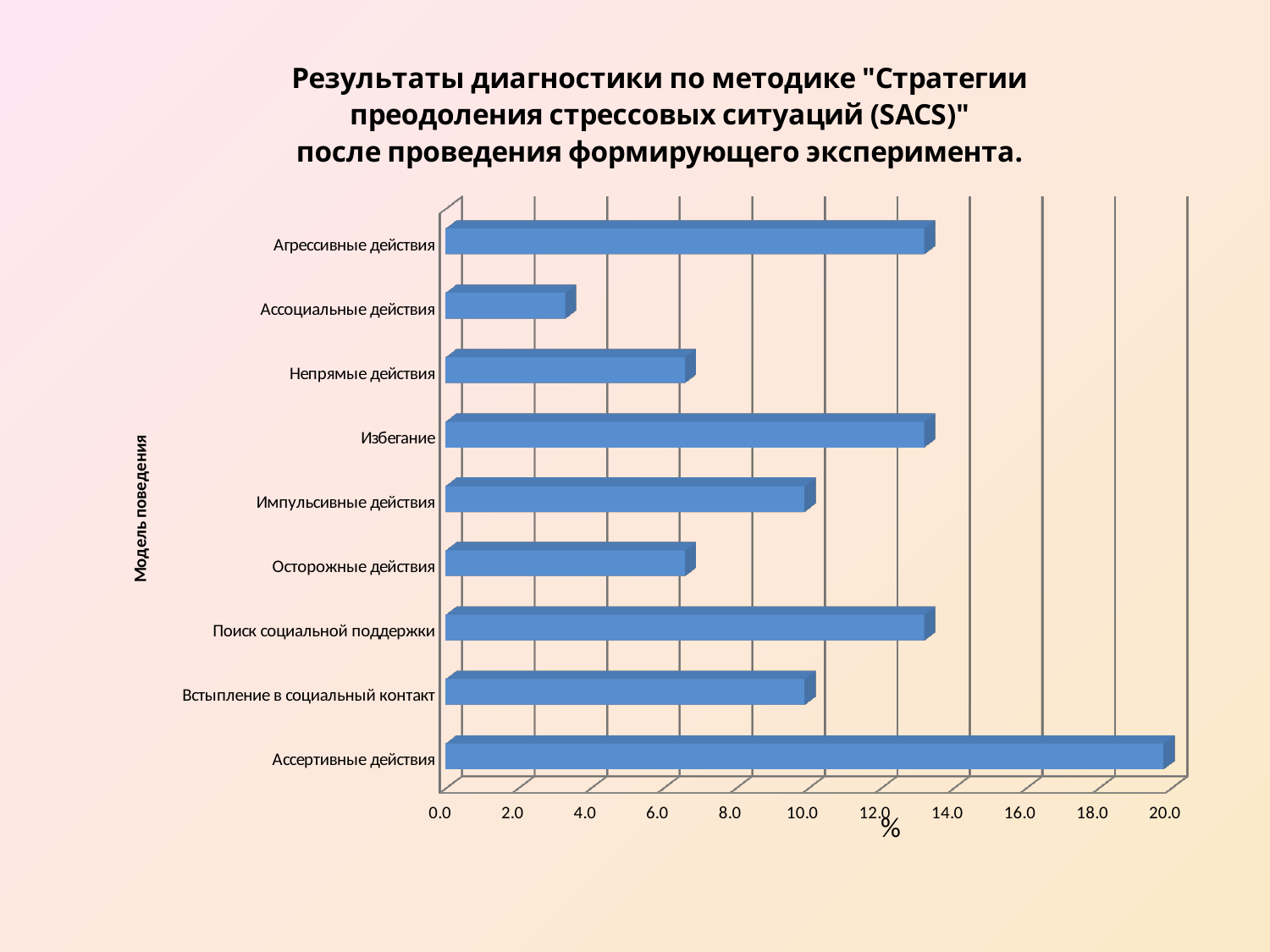
What kind of chart is shown on the slide? bar chart Is the value for Осторожные действия greater or less than 8.0? less Which is larger, the value for Агрессивные действия or the value for Непрямые действия? Агрессивные действия How many behaviour models (categories) are plotted on the chart? 9 What is the title of the vertical (category) axis? Модель поведения Which is larger, the value for Импульсивные действия or the value for Ассоциальные действия? Импульсивные действия Which behaviour model has the highest value on the chart? Ассертивные действия Is the value for Непрямые действия greater or less than 6.0? greater Is the value for Агрессивные действия greater or less than 12.0? greater Which behaviour model has the lowest value on the chart? Ассоциальные действия